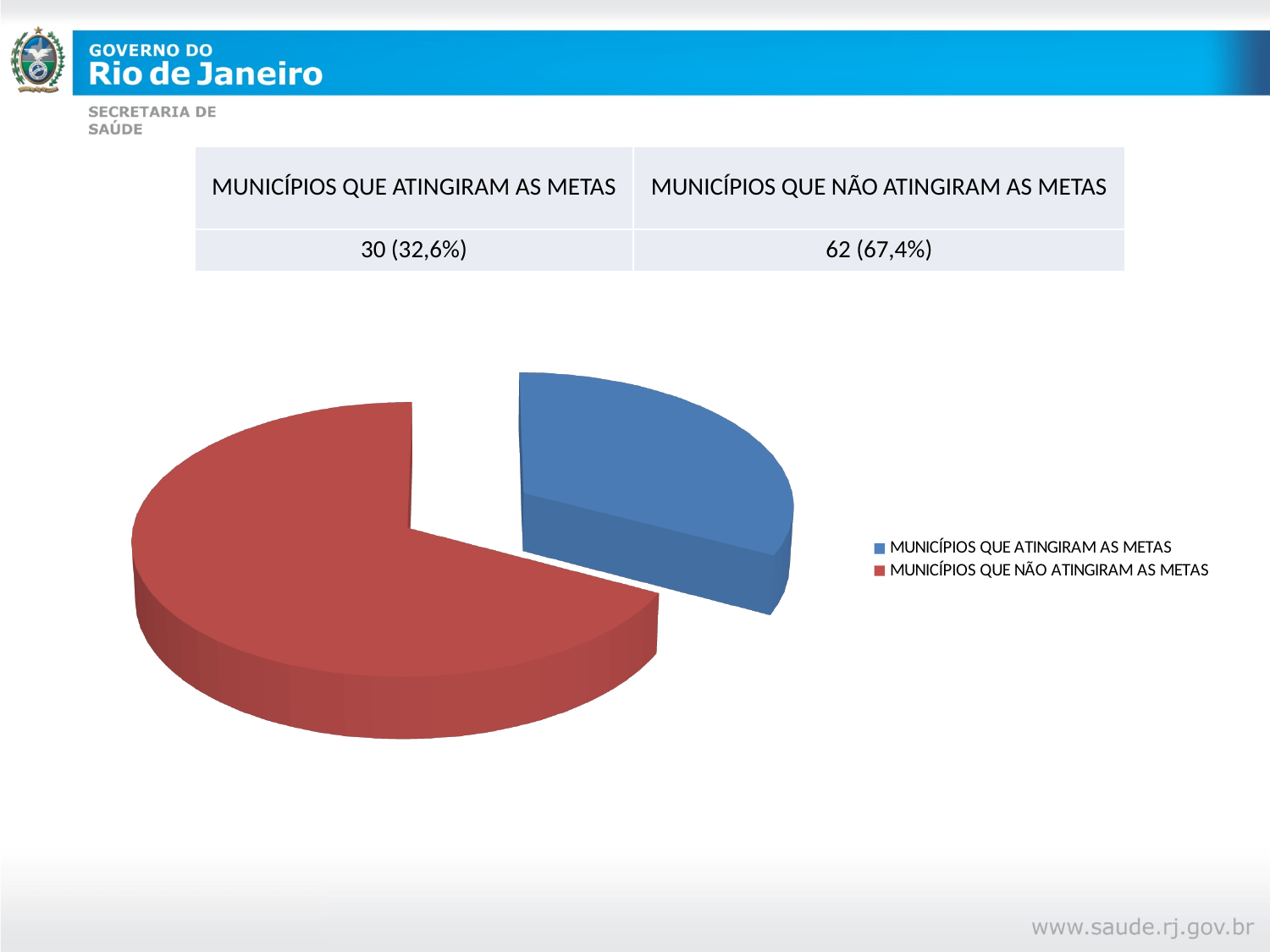
Which category has the largest slice in the pie chart? MUNICÍPIOS QUE NÃO ATINGIRAM AS METAS What colour is the slice for MUNICÍPIOS QUE NÃO ATINGIRAM AS METAS in the pie chart? red What kind of chart is shown on the slide? pie chart Which is larger: the slice for MUNICÍPIOS QUE ATINGIRAM AS METAS or the slice for MUNICÍPIOS QUE NÃO ATINGIRAM AS METAS? MUNICÍPIOS QUE NÃO ATINGIRAM AS METAS What is the difference between the number of municipalities that did not reach the targets and the number that did? 32 What share of the pie does the slice for MUNICÍPIOS QUE NÃO ATINGIRAM AS METAS represent, as printed in the table? 67,4% What share of the pie does the slice for MUNICÍPIOS QUE ATINGIRAM AS METAS represent, as printed in the table? 32,6% Which category has the smallest slice in the pie chart? MUNICÍPIOS QUE ATINGIRAM AS METAS How many slices does the pie chart have? 2 According to the table above the pie chart, how many municipalities did not reach the targets (MUNICÍPIOS QUE NÃO ATINGIRAM AS METAS)? 62 According to the table above the pie chart, how many municipalities reached the targets (MUNICÍPIOS QUE ATINGIRAM AS METAS)? 30 How many entries does the legend of the pie chart list? 2